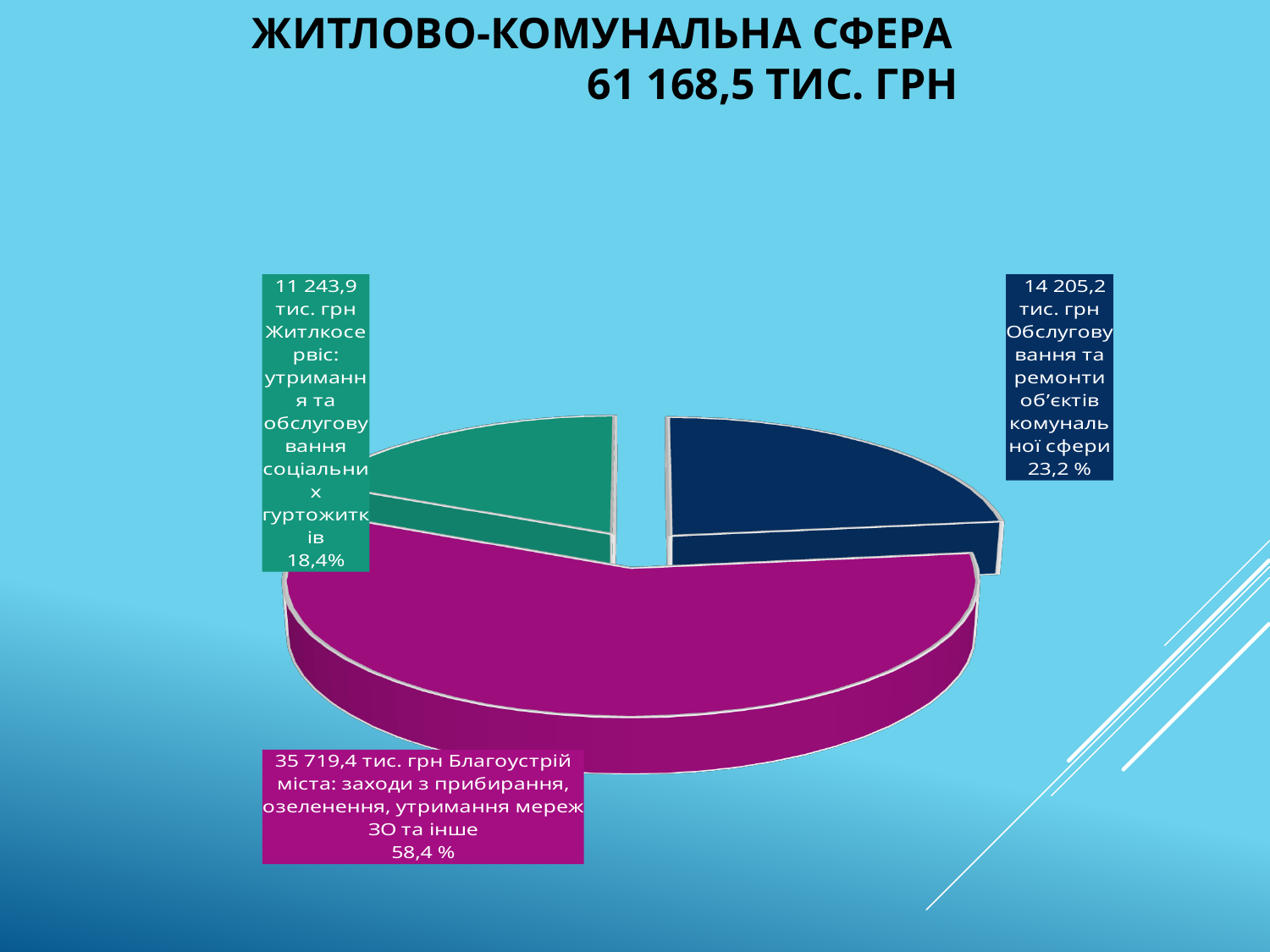
What is the value for "Обслуговування та ремонти об'єктів комунальної сфери"? 14 205,2 тис. грн What kind of chart is shown on the slide? pie chart What is the difference in тис. грн between "Благоустрій міста" and "Обслуговування та ремонти об'єктів комунальної сфери"? 21 514,2 тис. грн Which category has the largest slice of the pie? Благоустрій міста What share of the pie does "Обслуговування та ремонти об'єктів комунальної сфери" represent? 23,2 % What is the value for "Житлкосервіс: утримання та обслуговування соціальних гуртожитків"? 11 243,9 тис. грн What share of the pie does "Благоустрій міста" represent? 58,4 % What is the value for "Благоустрій міста" in the pie chart? 35 719,4 тис. грн What share of the pie does "Житлкосервіс" represent? 18,4% What total amount is stated in the chart title? 61 168,5 тис. грн How many slices does the pie chart have? 3 Which category has the smallest slice of the pie? Житлкосервіс: утримання та обслуговування соціальних гуртожитків